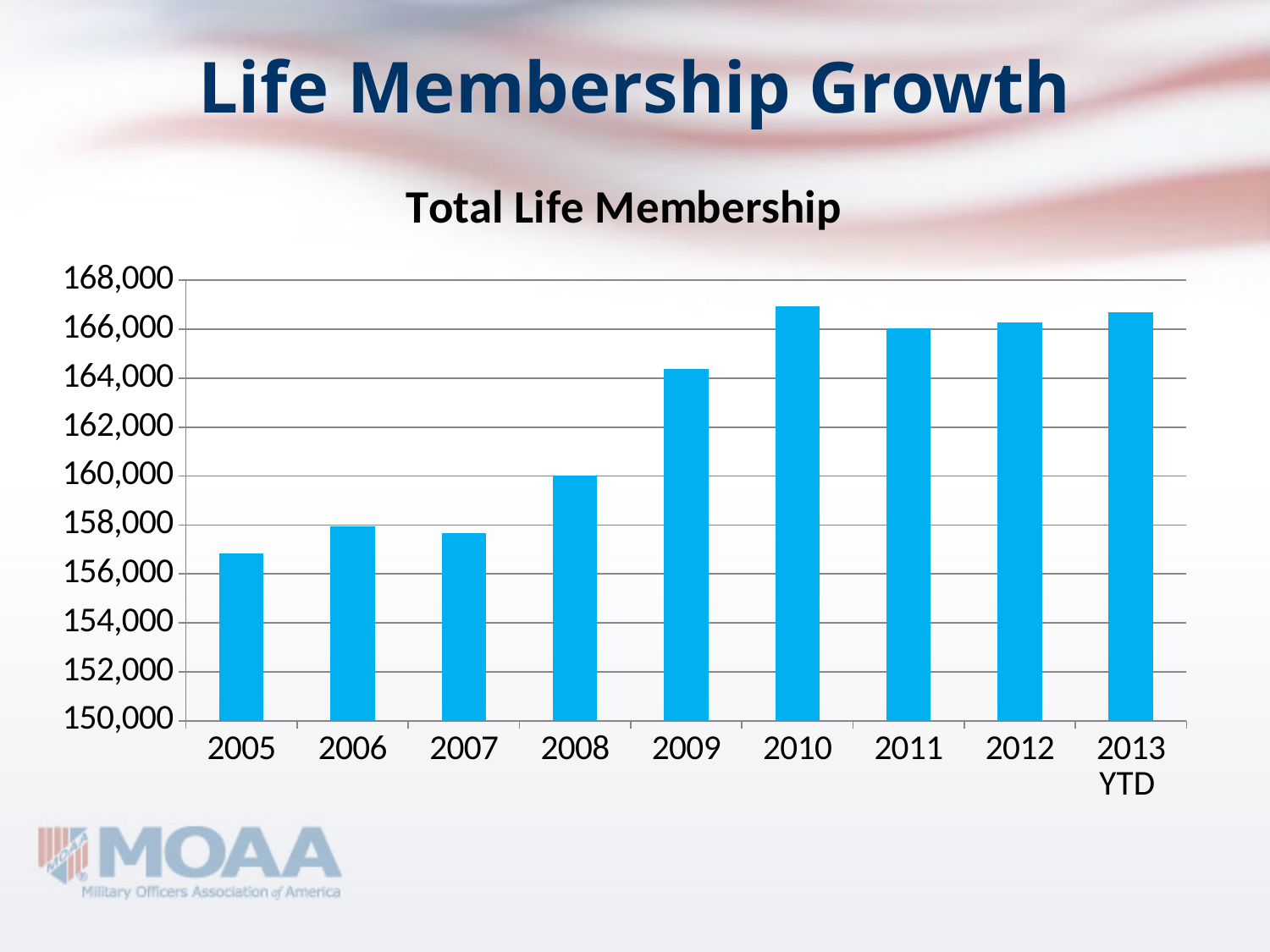
Which is larger, the value for 2008 or the value for 2009? 2009 Is the value for 2007 greater or less than 158,000? less Which is larger, the value for 2010 or the value for 2011? 2010 Is the value for 2010 greater or less than 166,000? greater Which year has the highest total life membership? 2010 Is the value for 2005 greater or less than 158,000? less Which year has the lowest total life membership? 2005 What type of chart is shown on the slide? Bar chart How many years (categories) are shown on the x axis? 9 What is the title of the chart? Total Life Membership Do the values generally rise or fall from 2005 to 2013 YTD? Rise